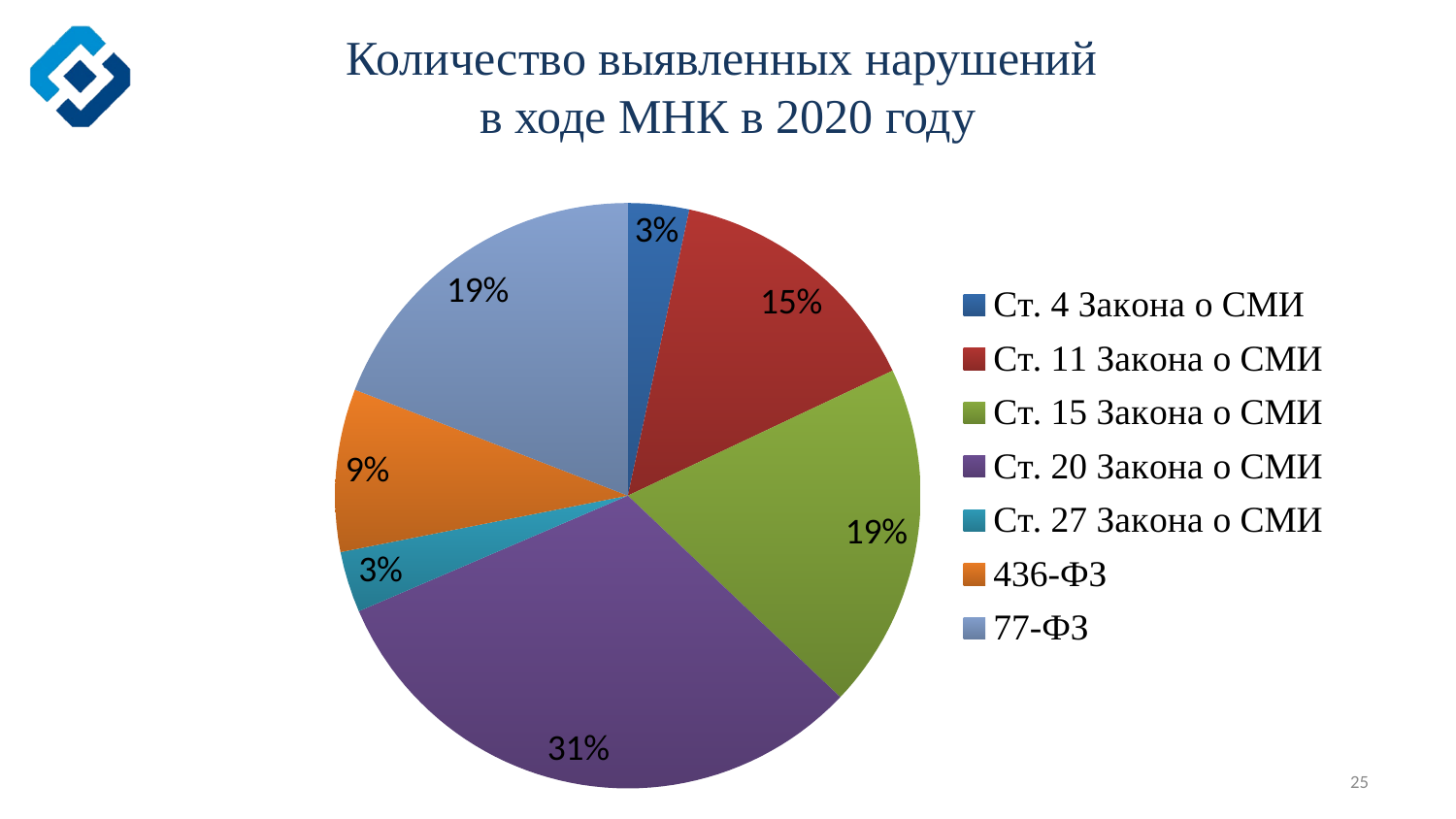
What is the difference in percentage points between the share for Ст. 20 Закона о СМИ and the share for Ст. 11 Закона о СМИ? 16 What share of the pie does Ст. 11 Закона о СМИ have? 15% Which legend entry is shown in orange? 436-ФЗ What share of the pie does Ст. 4 Закона о СМИ have? 3% How many categories does the pie chart have? 7 Which category has the largest slice of the pie? Ст. 20 Закона о СМИ What share of the pie does 436-ФЗ have? 9% Which is larger: the share for Ст. 11 Закона о СМИ or the share for 436-ФЗ? Ст. 11 Закона о СМИ What is the title of the chart? Количество выявленных нарушений в ходе МНК в 2020 году What kind of chart is shown on the slide? Pie chart